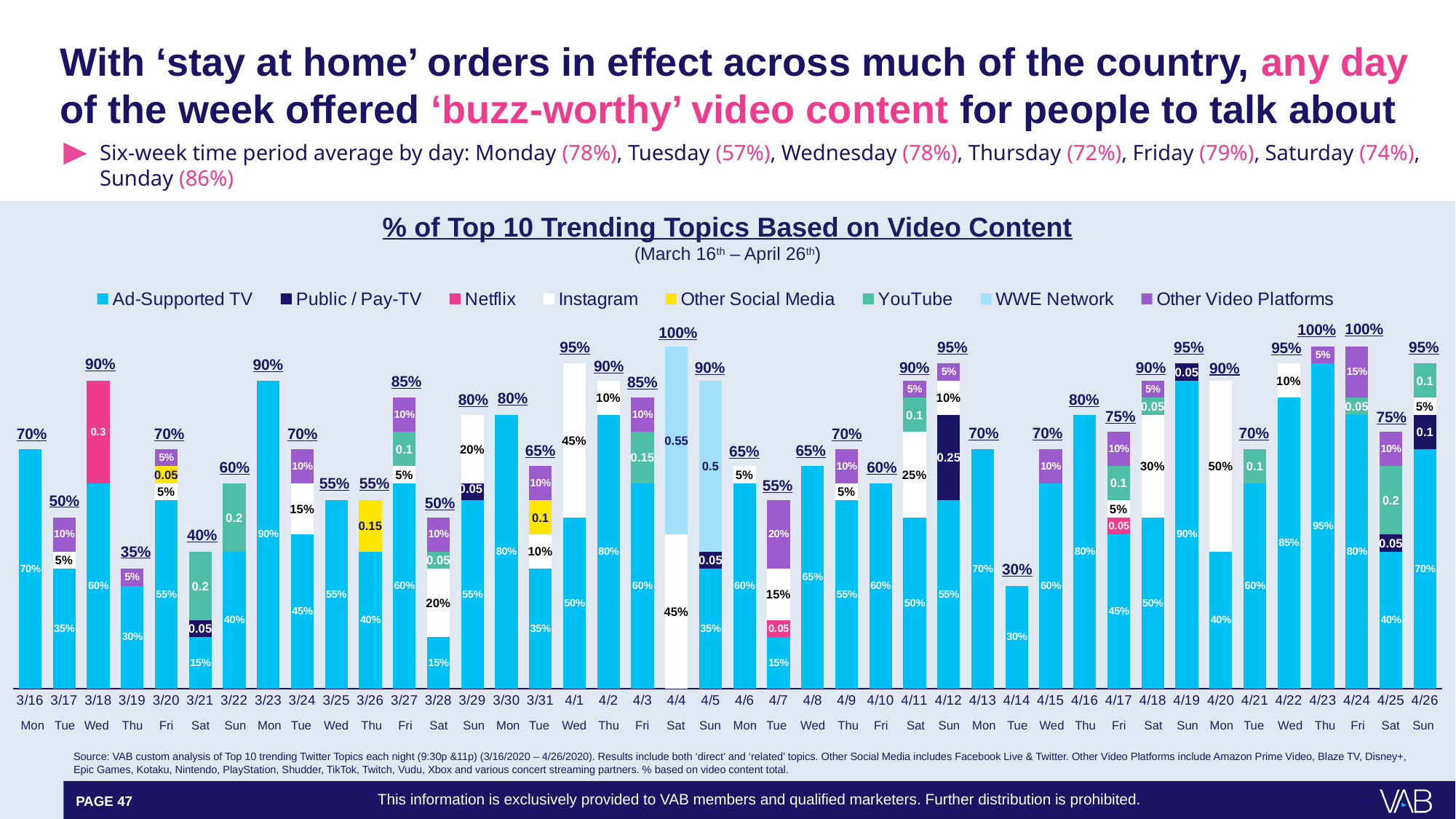
How many series does the legend list? 8 What is the difference between the total for 3/18 and the total for 3/19? 55% What is the Instagram value labelled on the 4/20 bar? 50% What is the Netflix value labelled on the 3/18 bar? 0.3 What is the Ad-Supported TV value for 3/23? 90% How many dates are plotted along the x axis? 42 Which date has the lowest total bar? 4/14 What is the total percentage shown above the bar for 4/14? 30% Which date has the larger total bar, 4/1 or 4/2? 4/1 What date range is given in the chart subtitle? March 16th – April 26th What kind of chart is shown on the slide? Stacked bar chart What is the WWE Network value labelled on the 4/4 bar? 0.55